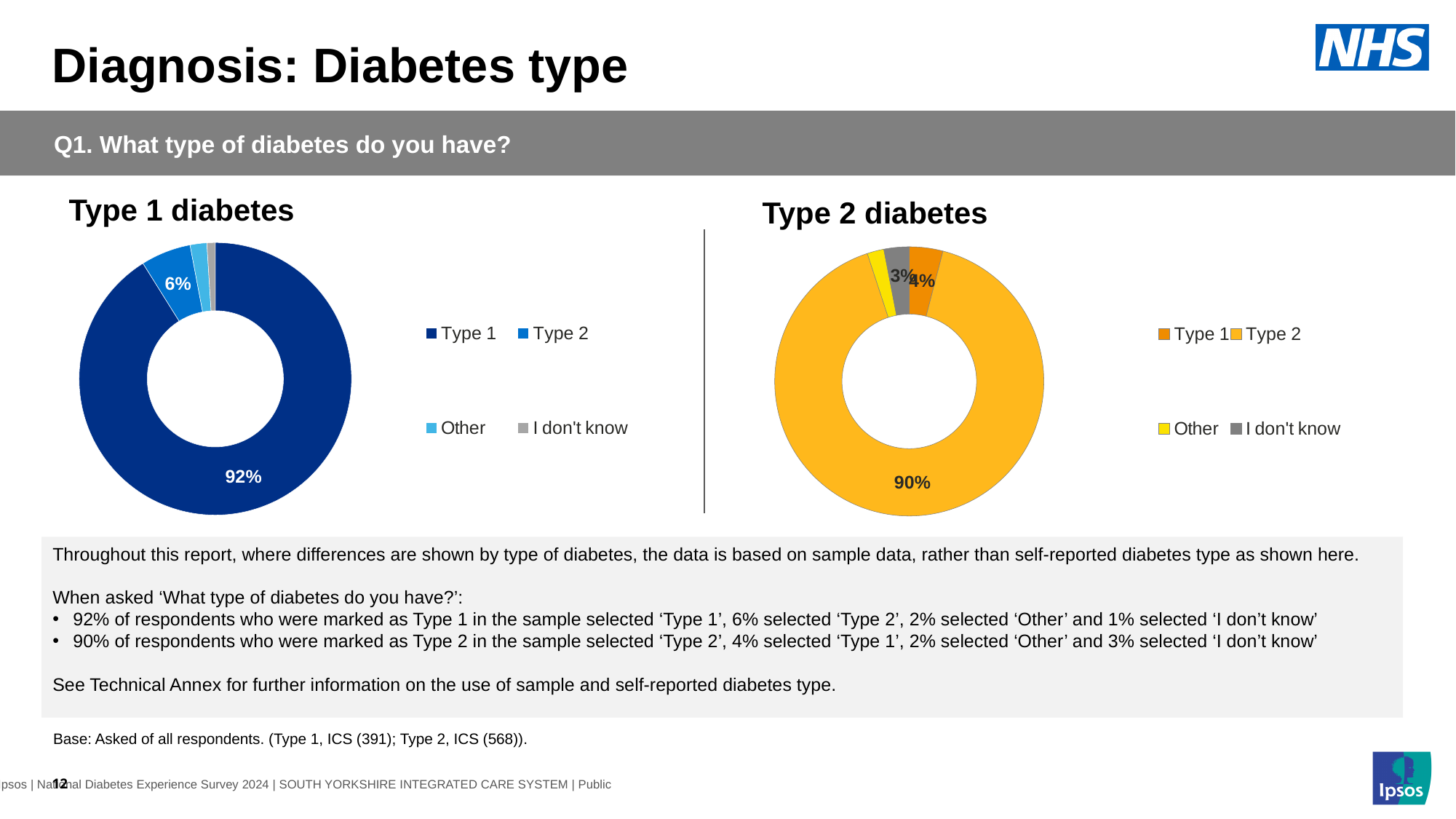
In the Type 2 diabetes chart, which is larger: the 'Type 1' slice or the 'I don't know' slice? Type 1 In the Type 1 diabetes chart, which category has the largest slice? Type 1 How many categories does the legend of the Type 2 diabetes chart list? 4 In the Type 2 diabetes chart, what percentage of respondents selected 'Type 2'? 90% In the Type 2 diabetes chart, what percentage of respondents selected 'I don't know'? 3% In the Type 1 diabetes chart, what percentage of respondents selected 'Type 2'? 6% In the Type 2 diabetes chart, what is the difference in percentage points between the 'Type 2' and 'Type 1' slices? 86 percentage points In the Type 2 diabetes chart, what percentage of respondents selected 'Type 1'? 4% What kind of chart is used for the Type 1 diabetes data? Pie (doughnut) chart In the Type 1 diabetes chart, what is the difference in percentage points between the 'Type 1' and 'Type 2' slices? 86 percentage points In the Type 2 diabetes chart, which category has the largest slice? Type 2 In the Type 1 diabetes chart, what percentage of respondents selected 'Type 1'? 92%